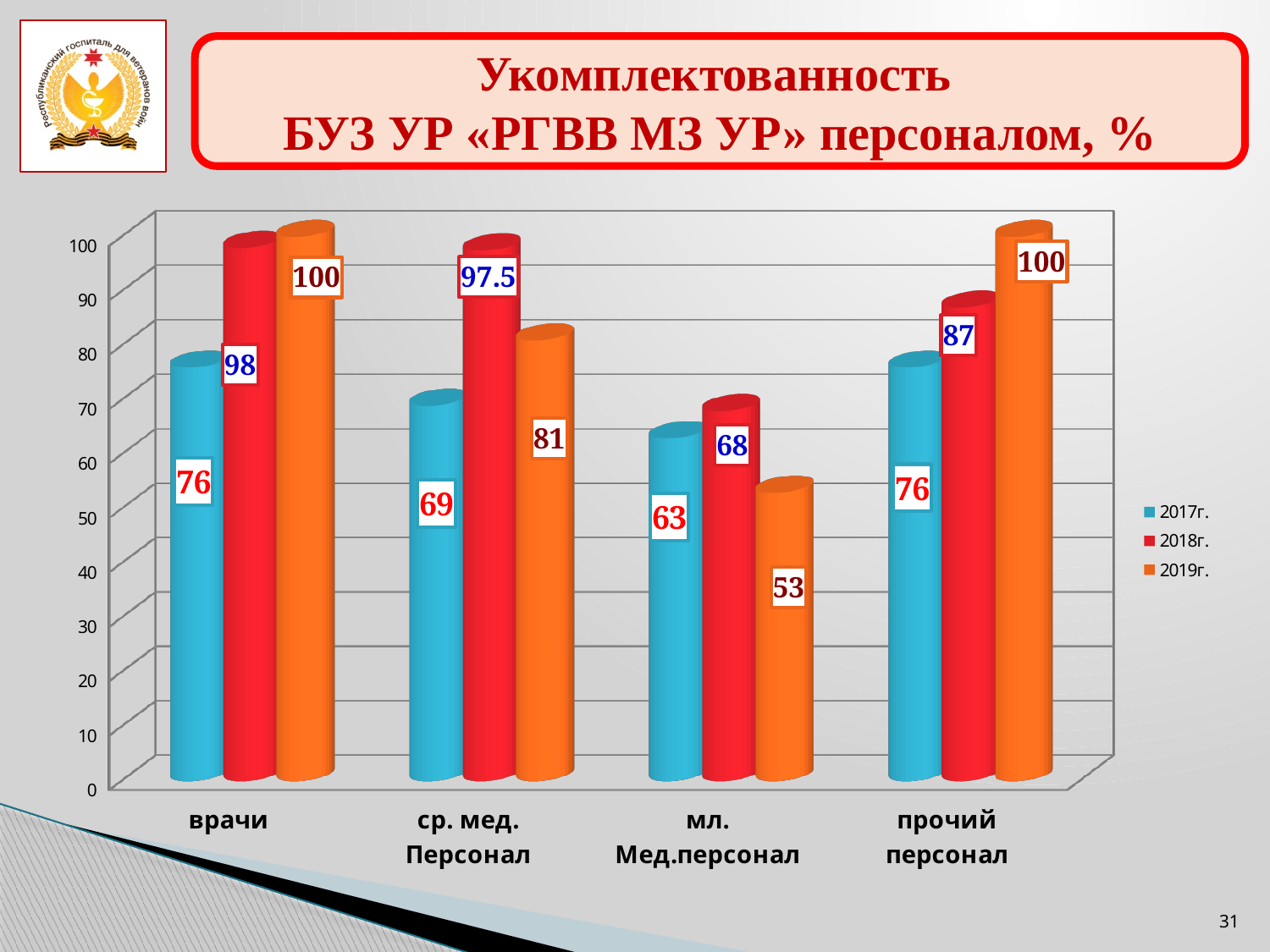
What is the difference between the 2019г. and 2017г. values for ср. мед. Персонал? 12 How many categories are shown on the x axis? 4 Which colour represents the 2018г. series in the legend? red What is the value for мл. Мед.персонал in the 2019г. series? 53 Which category has the lowest value in the 2017г. series? мл. Мед.персонал Which is larger for мл. Мед.персонал: the 2018г. value or the 2019г. value? 2018г. What is the value for врачи in the 2019г. series? 100 What is the value for прочий персонал in the 2017г. series? 76 Which category has the highest value in the 2018г. series? врачи How many series does the legend list? 3 What is the value for ср. мед. Персонал in the 2018г. series? 97.5 What kind of chart is shown on the slide? bar chart